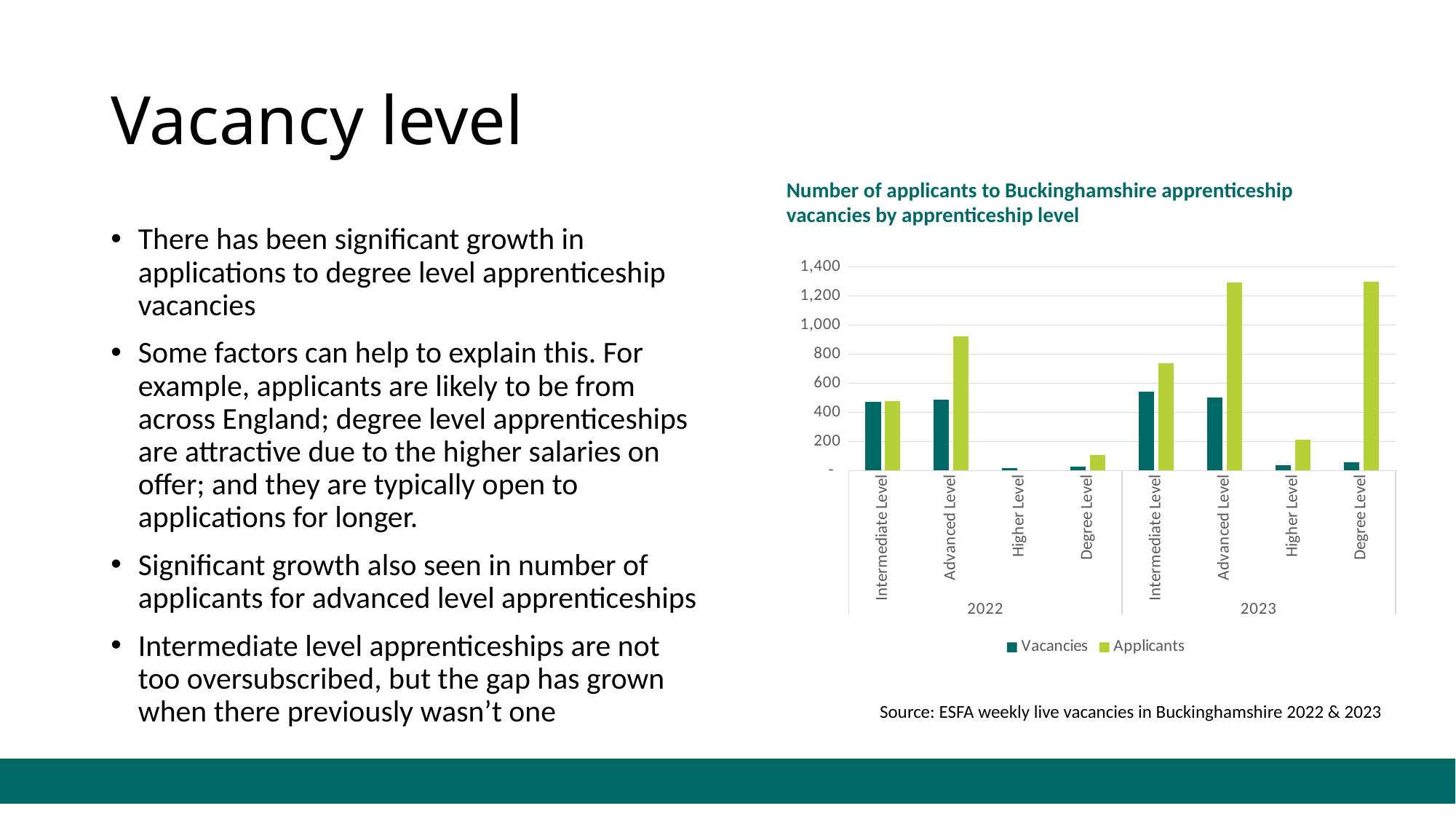
Which category has the lowest Applicants value on the chart? Higher Level (2022) Is the value for Applicants at Advanced Level in 2023 greater or less than 1,200? greater What kind of chart is shown on the slide? bar chart What is the title of the chart? Number of applicants to Buckinghamshire apprenticeship vacancies by apprenticeship level What are the two series named in the legend? Vacancies and Applicants Which is larger in 2022: Vacancies at Advanced Level or Applicants at Advanced Level? Applicants at Advanced Level Is the value for Vacancies at Intermediate Level in 2023 greater or less than 400? greater Which is larger in 2023: Applicants at Intermediate Level or Applicants at Higher Level? Applicants at Intermediate Level Is the value for Applicants at Advanced Level in 2022 greater or less than 1,000? less How many apprenticeship level categories are plotted across both years? 8 How many series does the legend list? 2